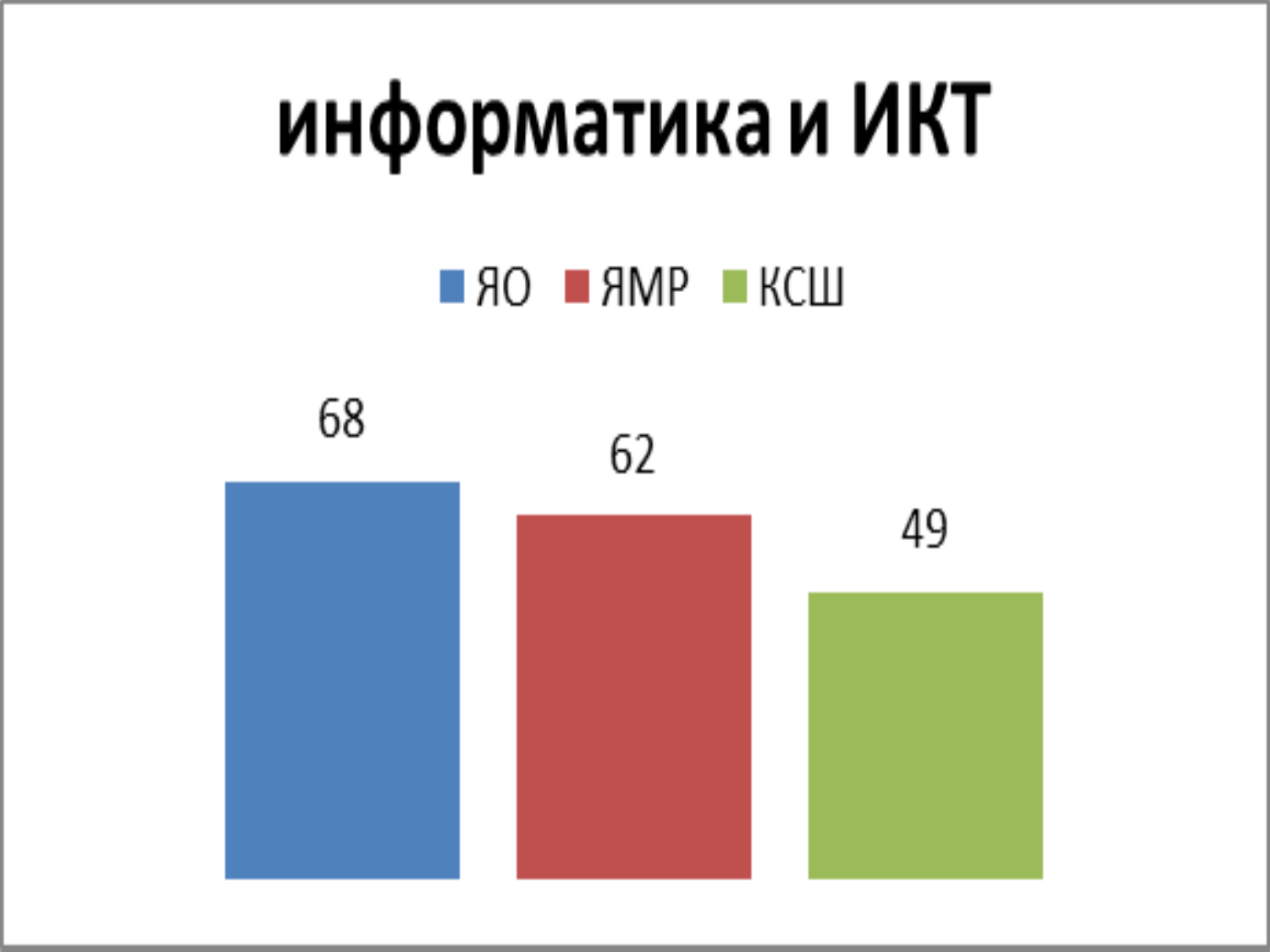
What is the difference between the values for ЯО and ЯМР? 6 What is the value for ЯО? 68 Which is larger, the value for ЯМР or the value for КСШ? ЯМР What is the title of the chart? информатика и ИКТ Which series has the highest value? ЯО How many bars are plotted on the chart? 3 What is the value for ЯМР? 62 How many series does the legend list? 3 Which series has the lowest value? КСШ What is the value for КСШ? 49 What kind of chart is shown on the slide? bar chart What is the difference between the values for ЯО and КСШ? 19